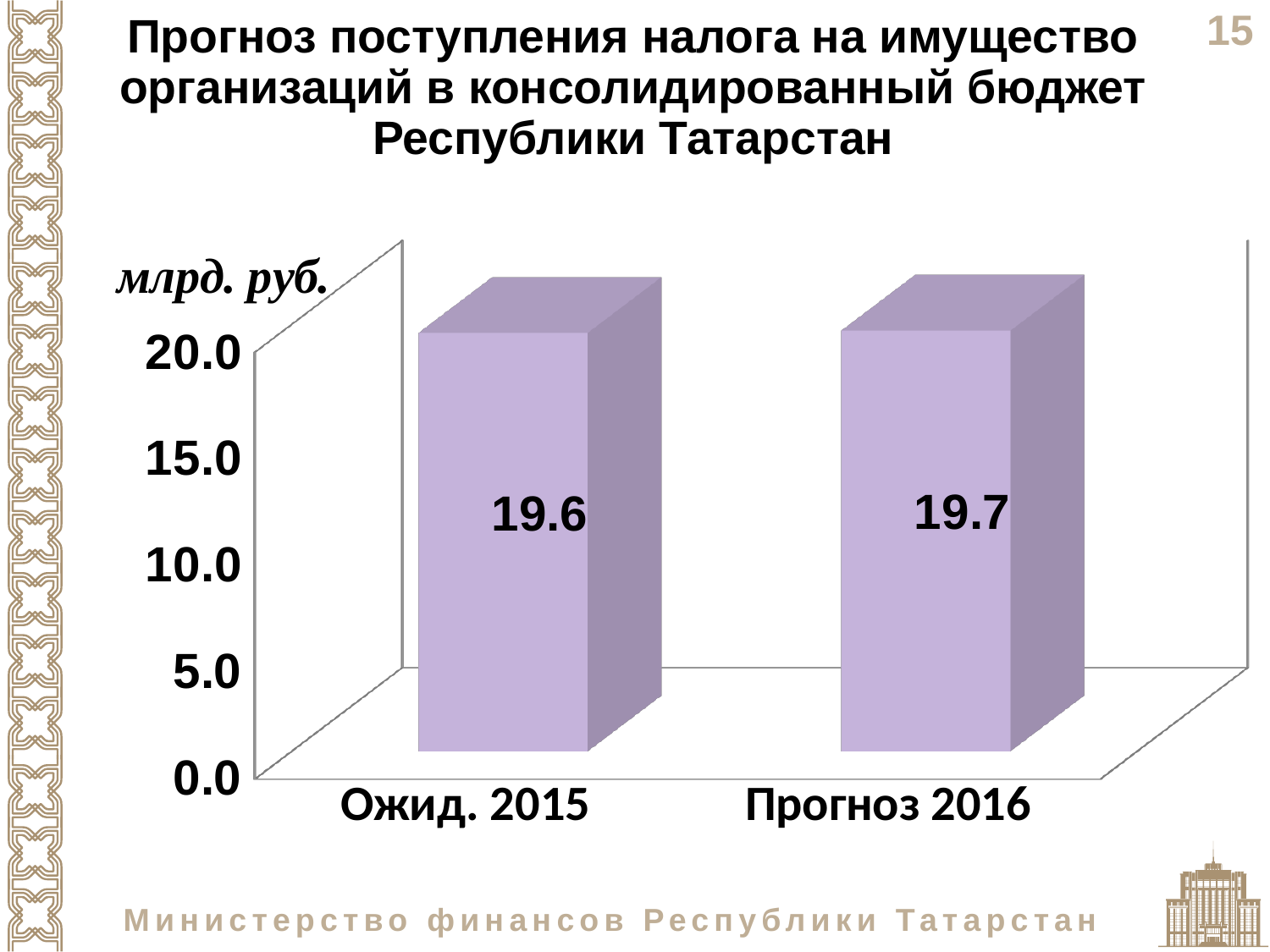
What is the difference between the values for Прогноз 2016 and Ожид. 2015? 0.1 Is the value for Ожид. 2015 greater or less than 15.0? greater Which category has the lowest value? Ожид. 2015 Which is larger, the value for Ожид. 2015 or the value for Прогноз 2016? Прогноз 2016 What is the value for Ожид. 2015? 19.6 What kind of chart is shown on the slide? bar chart Which category has the highest value? Прогноз 2016 How many categories are shown on the chart? 2 Is the value for Прогноз 2016 greater or less than 20.0? less Do the values rise or fall from Ожид. 2015 to Прогноз 2016? rise What is the value for Прогноз 2016? 19.7 What unit of measurement is shown on the chart? млрд. руб.